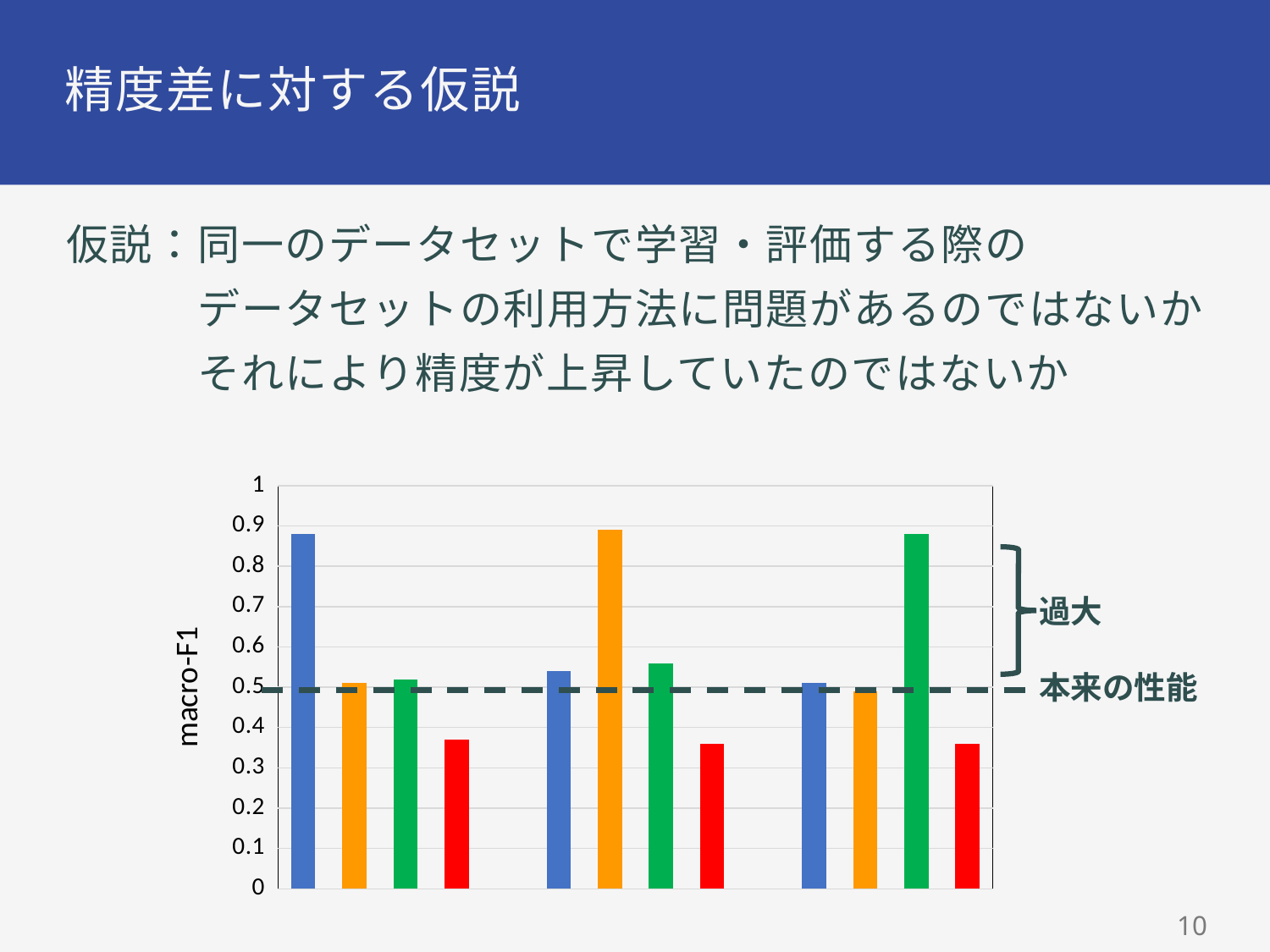
What is the label on the vertical axis of the chart? macro-F1 What kind of chart is shown on the slide? bar chart How many bars are in each group of the chart? 4 In the first (leftmost) group of bars, which colour bar is the tallest? blue Is the value of the green bar in the second (middle) group greater or less than 0.7? less How many groups of bars does the chart contain? 3 What label is written next to the dashed horizontal line on the chart? 本来の性能 In the first (leftmost) group of bars, which colour bar is the shortest? red In the third (rightmost) group of bars, which colour bar is the tallest? green Is the value of the blue bar in the first (leftmost) group greater or less than 0.8? greater Is the value of the red bar in the second (middle) group greater or less than 0.4? less In the second (middle) group of bars, which colour bar is the tallest? orange